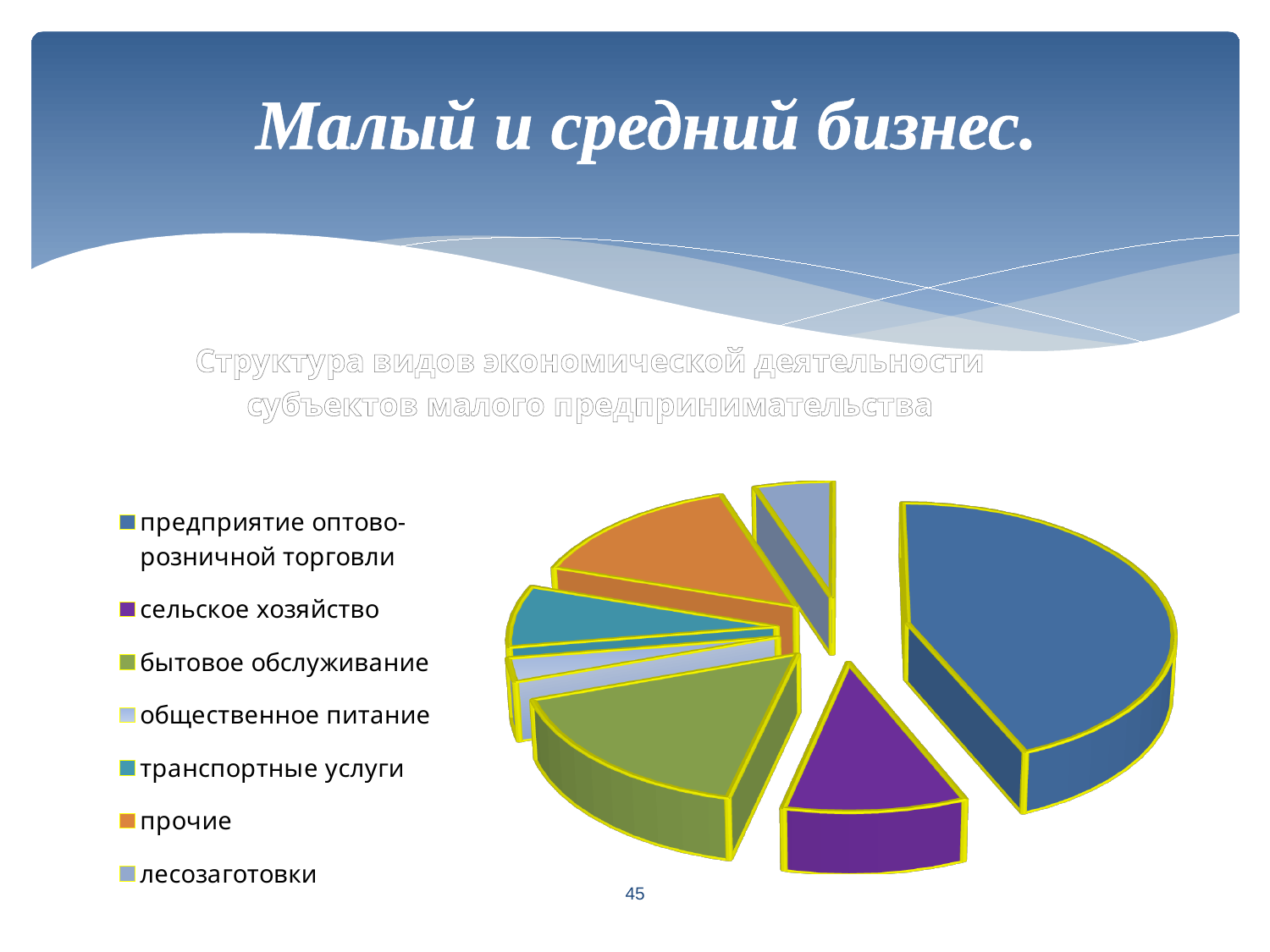
Which slice is larger: предприятие оптово-розничной торговли or сельское хозяйство? предприятие оптово-розничной торговли Which slice is larger: прочие or лесозаготовки? прочие Which slice is larger: бытовое обслуживание or сельское хозяйство? бытовое обслуживание What colour is the slice for сельское хозяйство? purple Which category has the largest slice of the pie chart? предприятие оптово-розничной торговли How many categories does the pie chart's legend list? 7 What kind of chart is shown on the slide? pie chart What is the title of the chart? Структура видов экономической деятельности субъектов малого предпринимательства